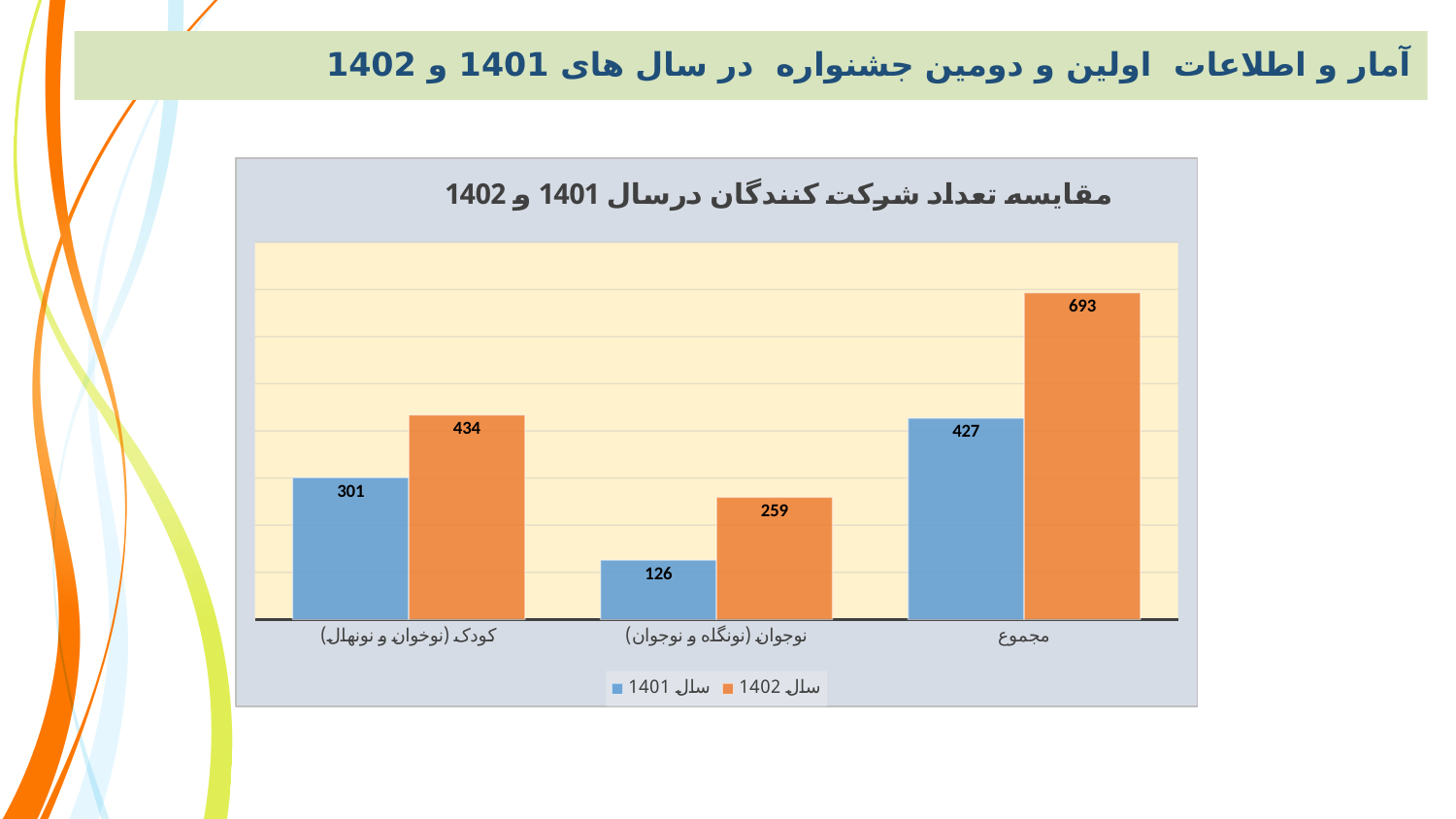
What is the value for سال 1402 in the مجموع category? 693 Which category has the highest value for سال 1402? مجموع What is the difference between the سال 1402 and سال 1401 values in the مجموع category? 266 Which category has the lowest value for سال 1401? نوجوان (نونگاه و نوجوان) Which is larger in the نوجوان (نونگاه و نوجوان) category: سال 1401 or سال 1402? سال 1402 How many series does the legend list? 2 What type of chart is shown on the slide? bar chart How many categories are shown on the x axis? 3 What is the value for سال 1402 in the کودک (نوخوان و نونهال) category? 434 What colour are the bars for سال 1402? orange What is the value for سال 1401 in the کودک (نوخوان و نونهال) category? 301 What is the value for سال 1401 in the نوجوان (نونگاه و نوجوان) category? 126